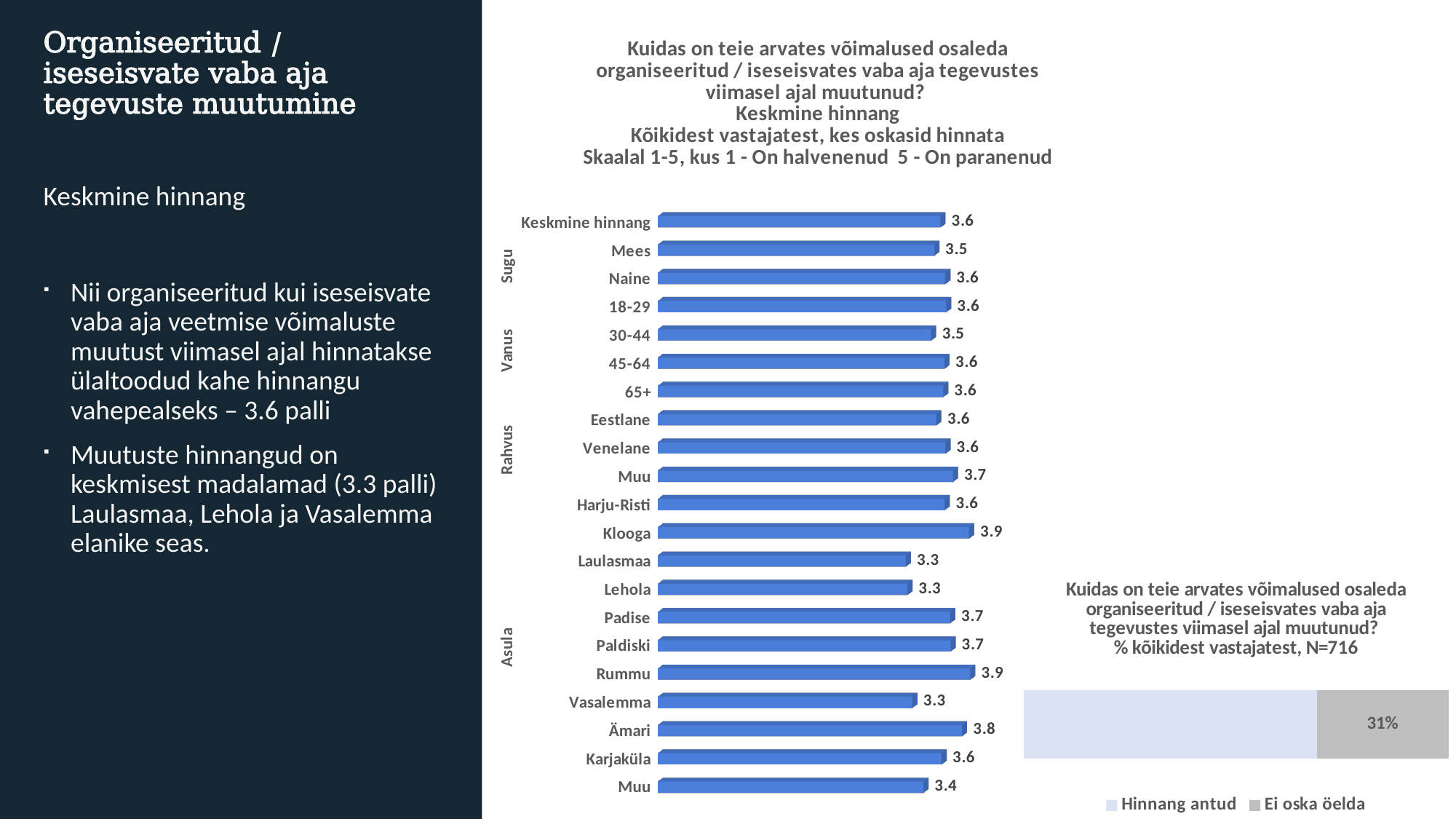
On the main bar chart, which has the higher value, Padise or Vasalemma? Padise On the main bar chart, what is the value for Muu in the Rahvus group? 3.7 On the main bar chart, what is the average rating (Keskmine hinnang) for Klooga? 3.9 On the main bar chart, what is the difference between the values for Klooga and Laulasmaa? 0.6 On the main bar chart, what is the value for Mees? 3.5 On the main bar chart, which has the higher value, Ämari or Karjaküla? Ämari On the main bar chart, what is the value for Muu in the Asula group? 3.4 How many bars are plotted on the main bar chart? 21 On the small stacked bar chart at the bottom right, what is the value for Ei oska öelda? 31% How many series does the legend of the small stacked bar chart at the bottom right list? 2 On the main bar chart, what is the value for Ämari? 3.8 What kind of chart is the main chart on the slide? Bar chart